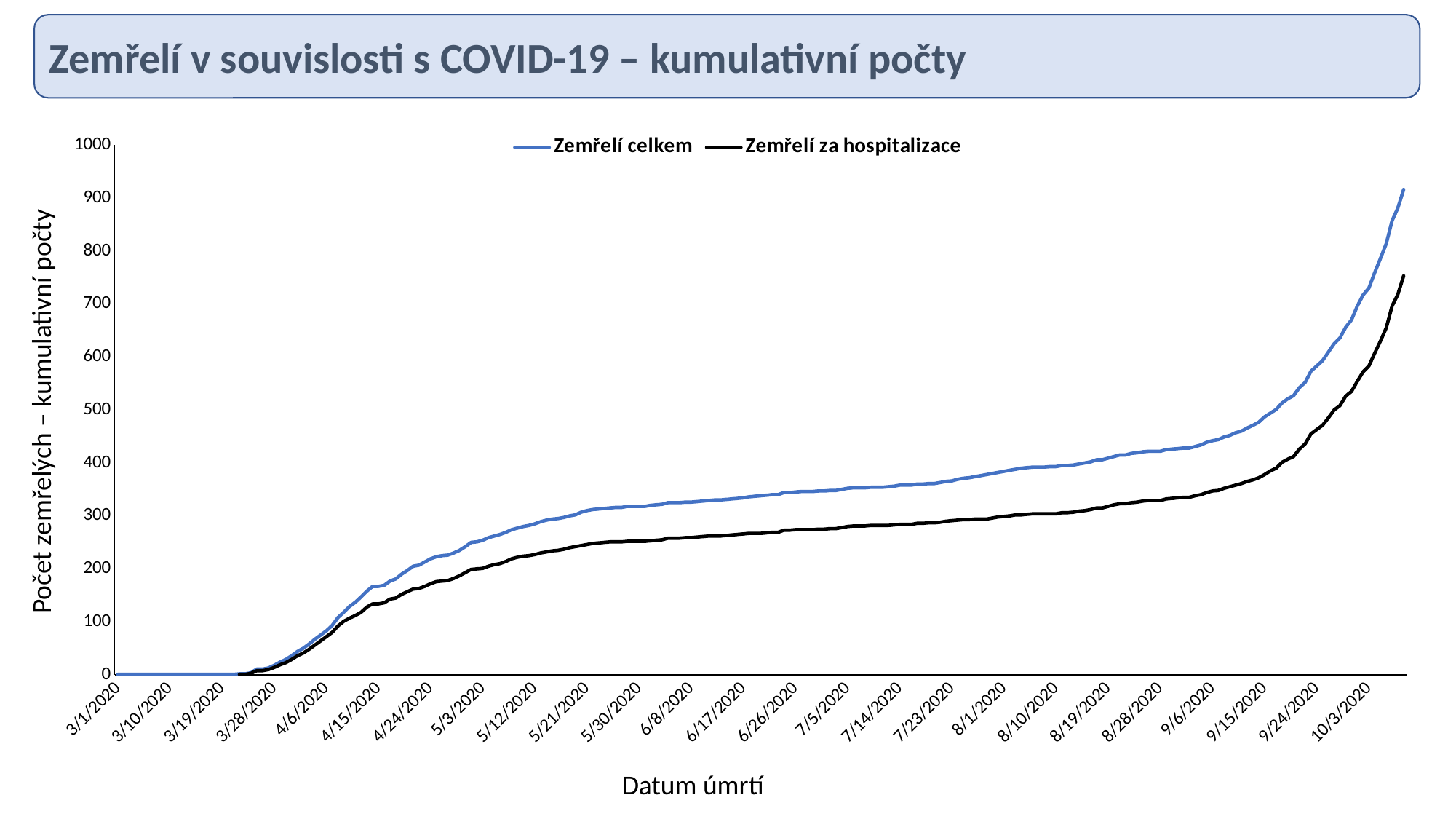
Is the value for Zemřelí celkem on 9/6/2020 greater or less than 400? greater Do the values for Zemřelí celkem rise or fall along the x axis? rise What is the title of the chart? Zemřelí v souvislosti s COVID-19 – kumulativní počty Is the value for Zemřelí za hospitalizace on 9/6/2020 greater or less than 400? less Is the value for Zemřelí celkem on 4/15/2020 greater or less than 100? greater How many series does the legend list? 2 Which series is higher on 9/24/2020, Zemřelí celkem or Zemřelí za hospitalizace? Zemřelí celkem What is the label of the x axis? Datum úmrtí What kind of chart is shown on the slide? line chart